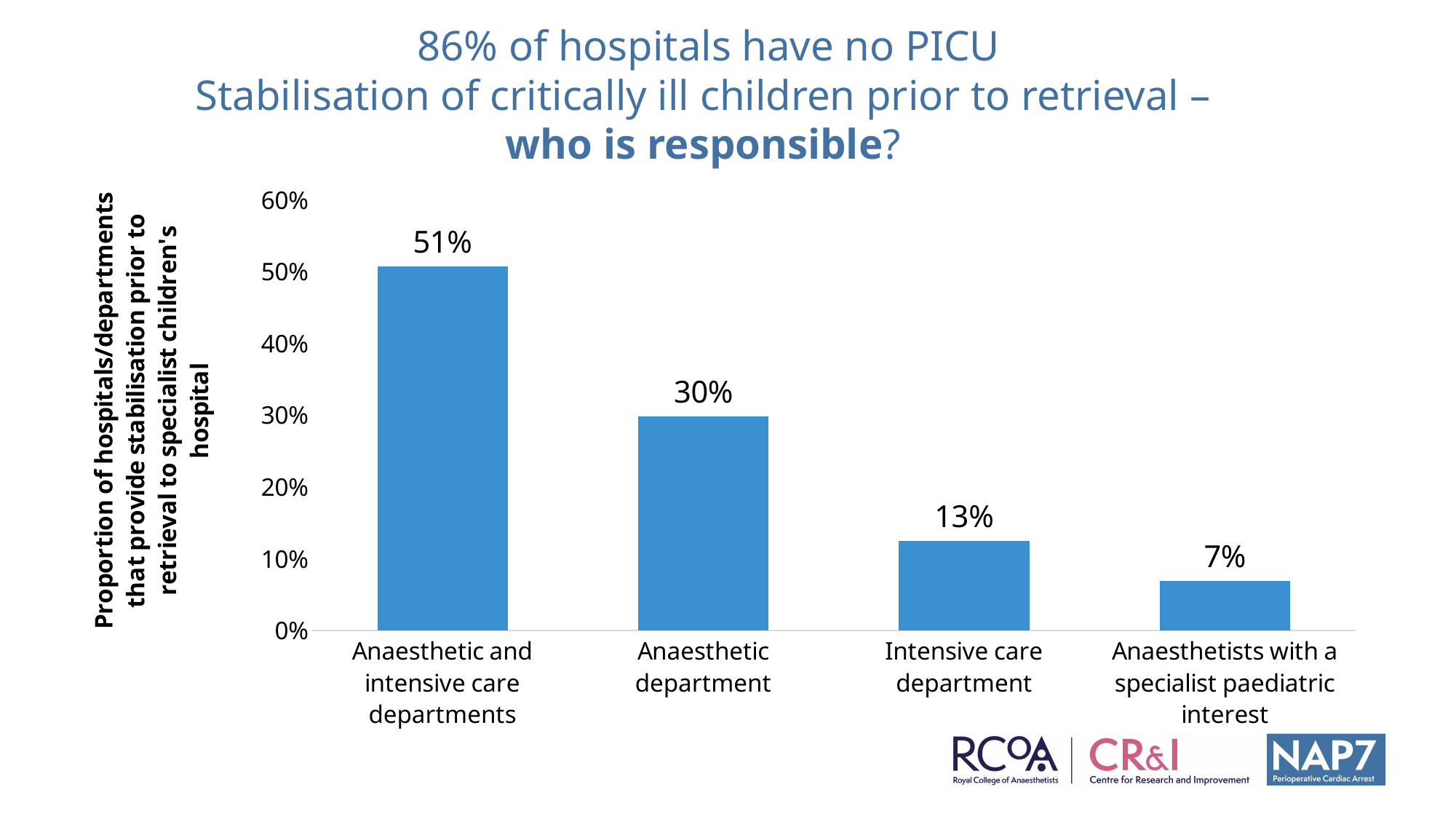
Which category has the lowest value? Anaesthetists with a specialist paediatric interest Which category has the highest value? Anaesthetic and intensive care departments Do the values rise or fall from left to right along the x axis? Fall Which is larger, the value for Anaesthetic department or the value for Intensive care department? Anaesthetic department What is the value for Anaesthetic and intensive care departments? 51% What is the value for Anaesthetists with a specialist paediatric interest? 7% What kind of chart is shown on the slide? Bar chart How many categories are shown on the x axis? 4 What is the difference between the values for Intensive care department and Anaesthetists with a specialist paediatric interest? 6% What is the value for Intensive care department? 13% What is the difference between the values for Anaesthetic and intensive care departments and Anaesthetic department? 21% What is the value for Anaesthetic department? 30%